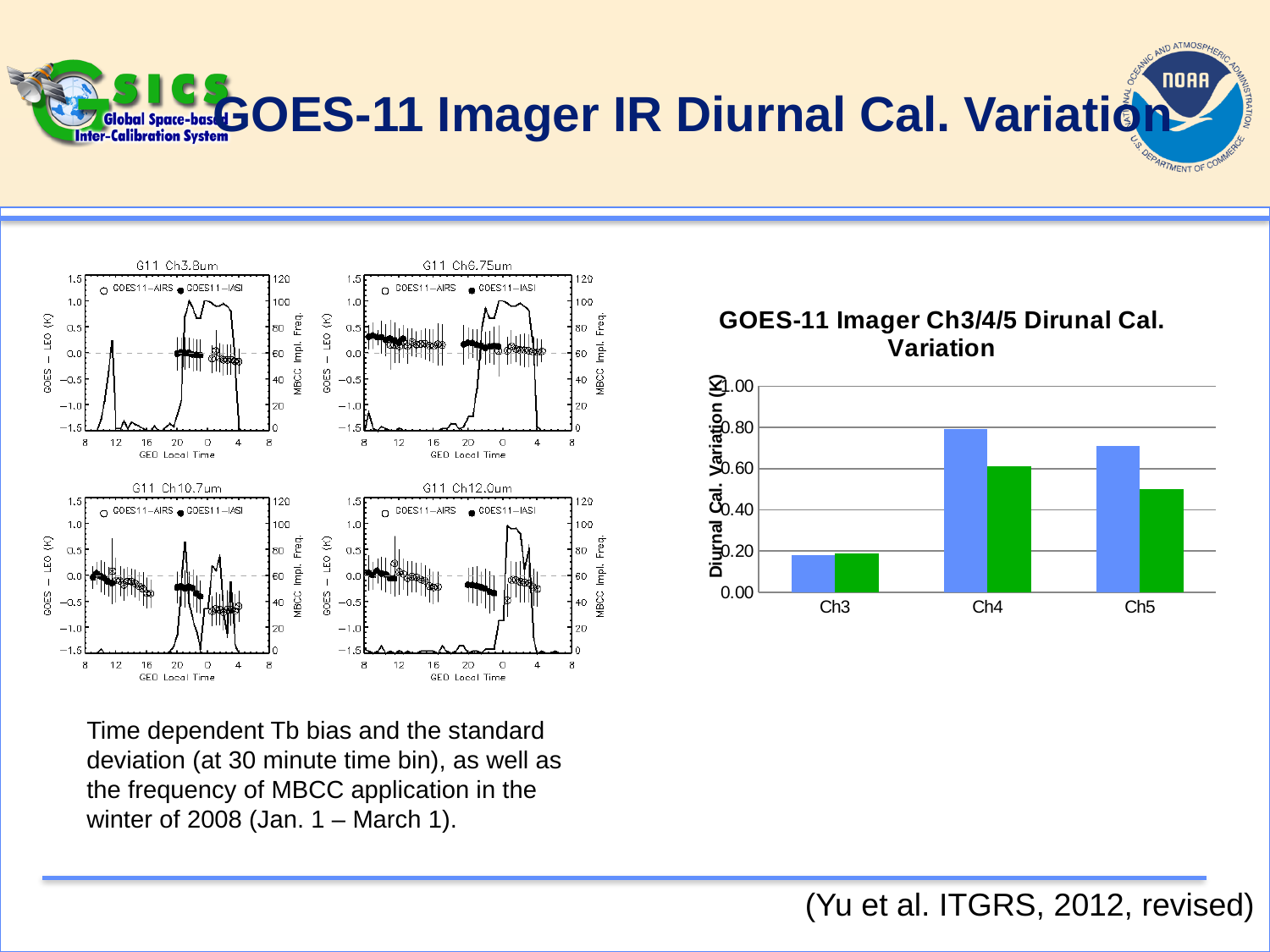
In the 'GOES-11 Imager Ch3/4/5 Dirunal Cal. Variation' bar chart, which is larger: the green bar for Ch4 or the green bar for Ch5? Ch4 In the 'GOES-11 Imager Ch3/4/5 Dirunal Cal. Variation' bar chart, how many bars are shown for each channel? 2 In the 'GOES-11 Imager Ch3/4/5 Dirunal Cal. Variation' bar chart, is the blue bar for Ch4 greater or less than 0.60? greater In the 'GOES-11 Imager Ch3/4/5 Dirunal Cal. Variation' bar chart, which channel has the lowest values? Ch3 In the 'GOES-11 Imager Ch3/4/5 Dirunal Cal. Variation' bar chart, which channel has the tallest blue bar? Ch4 What is the y-axis label of the 'GOES-11 Imager Ch3/4/5 Dirunal Cal. Variation' bar chart? Diurnal Cal. Variation (K) In the 'GOES-11 Imager Ch3/4/5 Dirunal Cal. Variation' bar chart, is the blue bar for Ch3 greater or less than 0.40? less In the 'GOES-11 Imager Ch3/4/5 Dirunal Cal. Variation' bar chart, is the green bar for Ch5 greater or less than 0.40? greater What kind of chart is the 'GOES-11 Imager Ch3/4/5 Dirunal Cal. Variation' chart? bar chart How many categories are shown on the x axis of the 'GOES-11 Imager Ch3/4/5 Dirunal Cal. Variation' bar chart? 3 In the 'GOES-11 Imager Ch3/4/5 Dirunal Cal. Variation' bar chart, which is larger: the blue bar for Ch4 or the blue bar for Ch5? Ch4